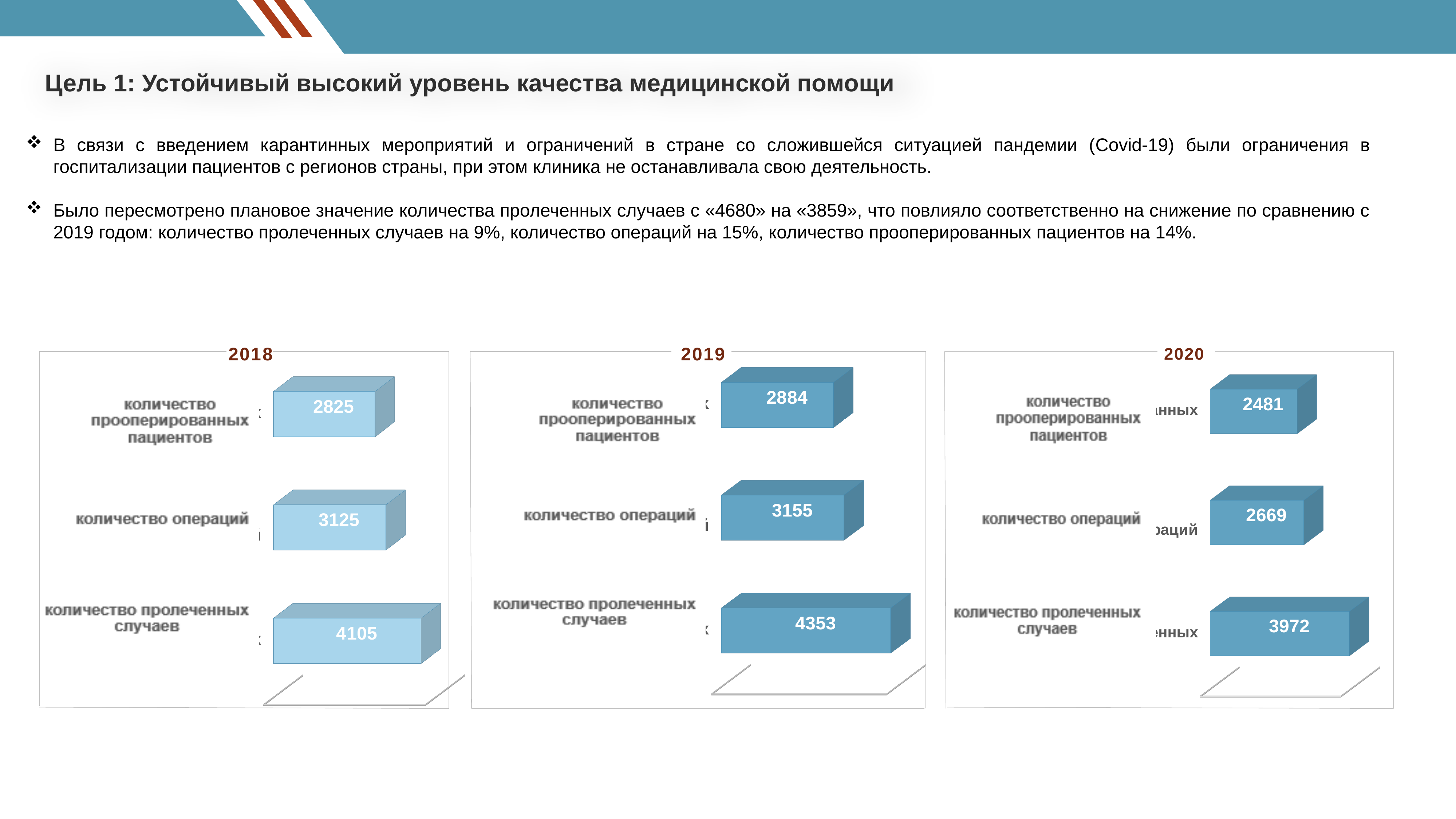
In the 2019 chart, what is the difference between количество пролеченных случаев and количество операций? 1198 In the 2018 chart, what is the value for количество прооперированных пациентов? 2825 In the 2020 chart, what is the value for количество прооперированных пациентов? 2481 How many charts are on the slide, and what are their titles? 3: 2018, 2019, 2020 In the 2020 chart, what is the difference between количество операций and количество прооперированных пациентов? 188 In the 2018 chart, which category has the lowest value? количество прооперированных пациентов In the 2019 chart, which category has the highest value? количество пролеченных случаев How many categories does the 2020 chart show? 3 What kind of chart is the 2019 chart? bar chart In the 2019 chart, what is the value for количество операций? 3155 Which is larger: количество операций in the 2018 chart or количество операций in the 2020 chart? 2018 chart (3125) In the 2020 chart, what is the value for количество пролеченных случаев? 3972